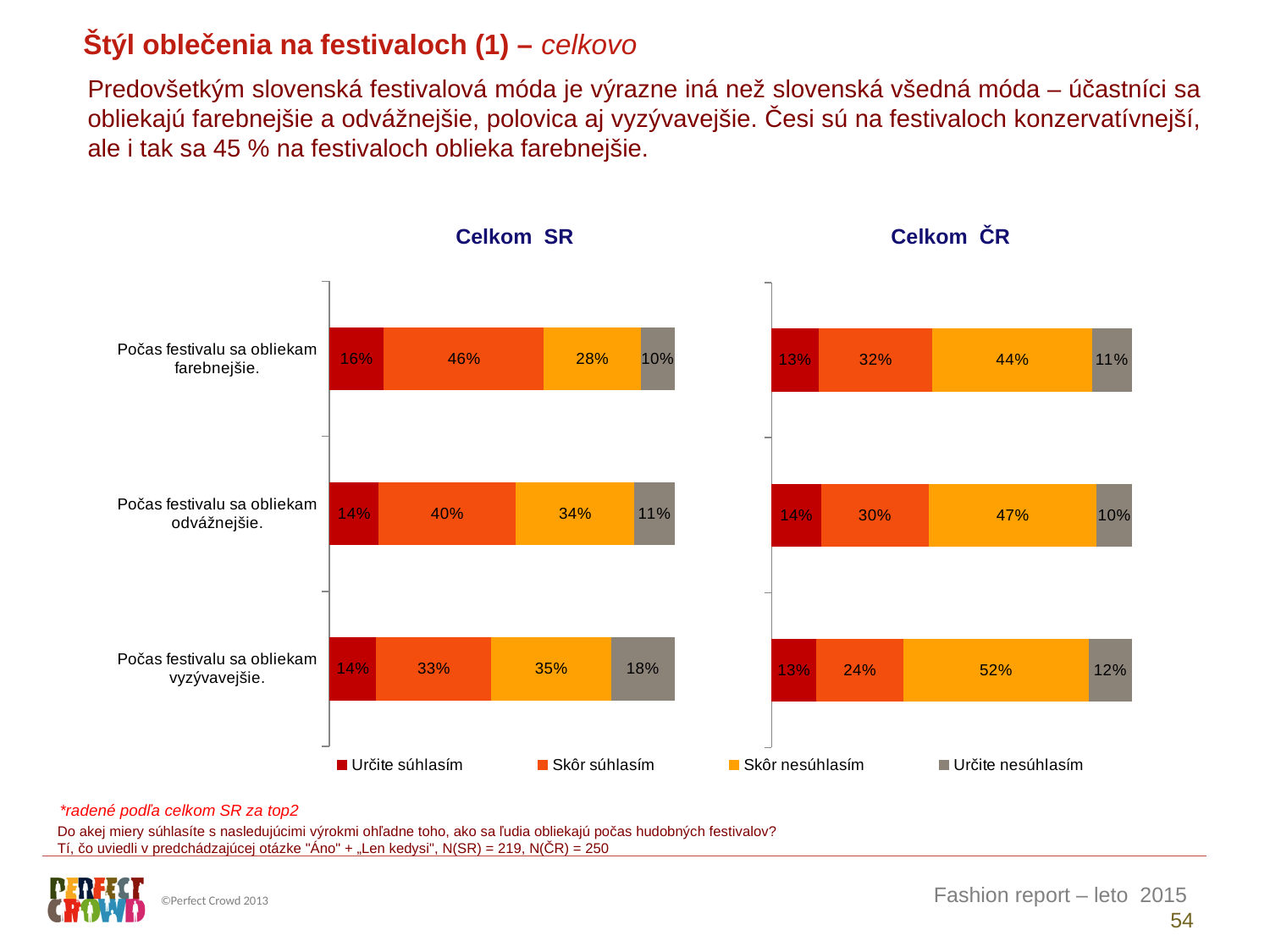
In the Celkom SR chart, what is the value of Určite nesúhlasím for "Počas festivalu sa obliekam vyzývavejšie."? 18% Which legend entry is shown in grey? Určite nesúhlasím How many statements (categories) are shown in the Celkom ČR chart? 3 In the Celkom SR chart, what is the value of Skôr súhlasím for "Počas festivalu sa obliekam farebnejšie."? 46% In the Celkom ČR chart, which statement has the lowest Skôr súhlasím value? Počas festivalu sa obliekam vyzývavejšie. In the Celkom ČR chart, what is the value of Určite súhlasím for "Počas festivalu sa obliekam odvážnejšie."? 14% In the Celkom SR chart, is the Skôr nesúhlasím value for "Počas festivalu sa obliekam odvážnejšie." larger or smaller than the Skôr súhlasím value for the same statement? smaller In the Celkom SR chart, which statement has the highest Skôr súhlasím value? Počas festivalu sa obliekam farebnejšie. How many series does the legend list? 4 What is the difference between the Skôr súhlasím values for "Počas festivalu sa obliekam farebnejšie." in the Celkom SR chart and the Celkom ČR chart? 14 percentage points What type of chart is the Celkom SR chart? Stacked bar chart In the Celkom ČR chart, what is the value of Skôr nesúhlasím for "Počas festivalu sa obliekam vyzývavejšie."? 52%